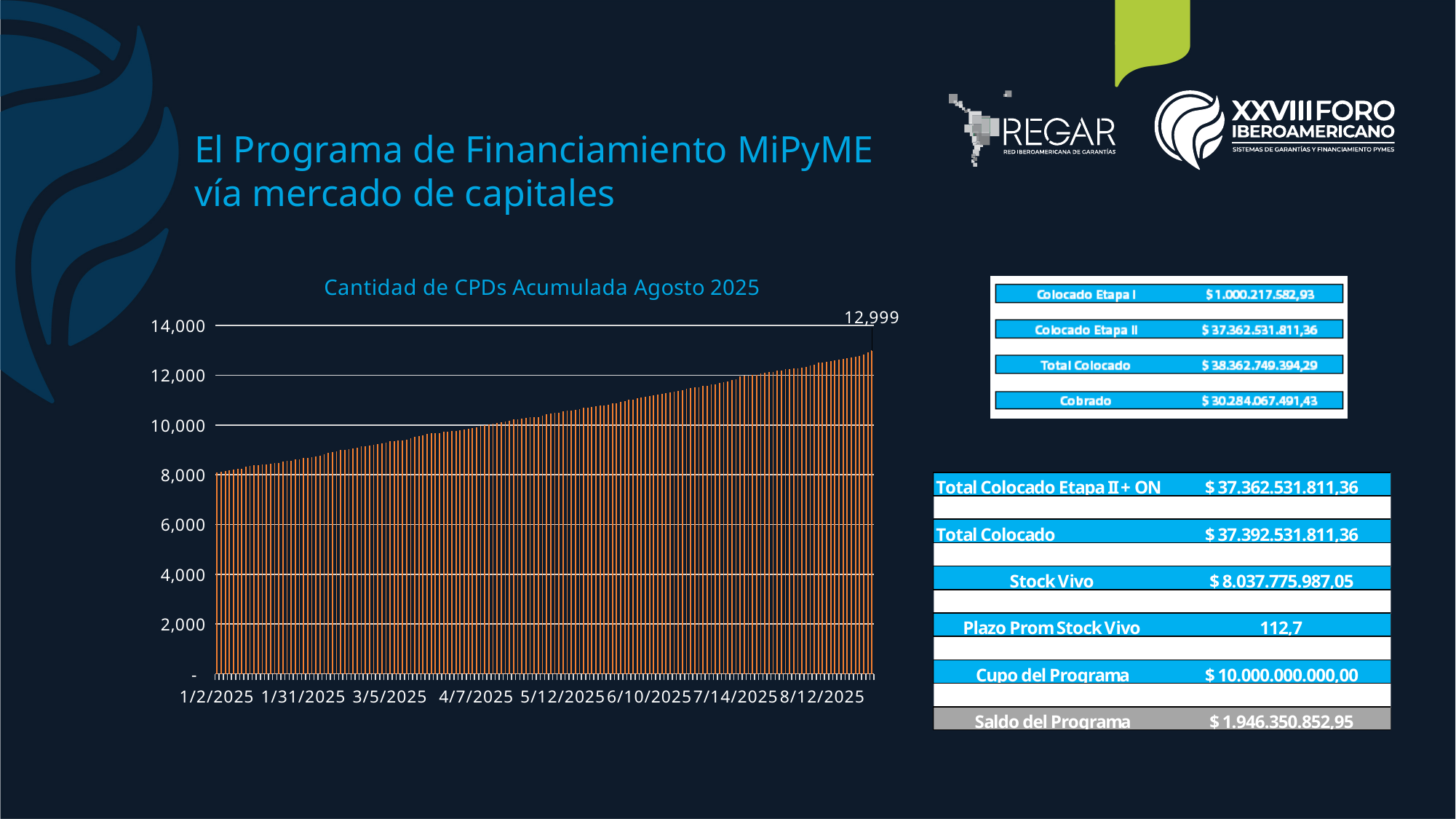
Is the value for 1/2/2025 greater or less than 10,000? less What is the highest value labelled on the chart? 12,999 What kind of chart is shown on the slide? bar chart What is the value shown by the data label at the end of the series in the chart? 12,999 Is the value for 3/5/2025 greater or less than 10,000? less Is the value for 6/10/2025 greater or less than 10,000? greater Do the values in the chart rise or fall from 1/2/2025 to the end of the series? rise What is the title of the chart? Cantidad de CPDs Acumulada Agosto 2025 What is the highest tick value shown on the vertical axis of the chart? 14,000 Which is larger, the value for 1/2/2025 or the value for 8/12/2025? 8/12/2025